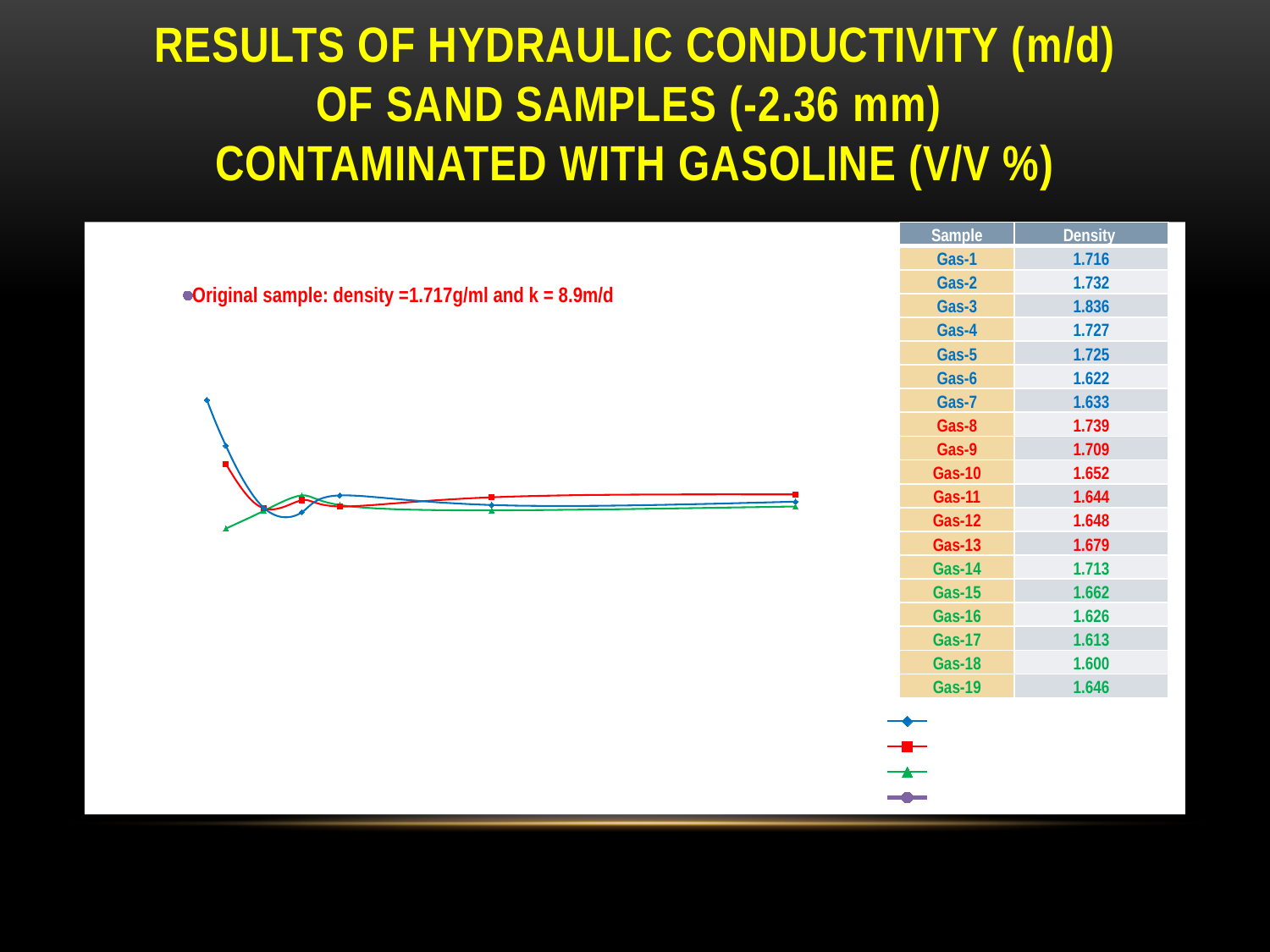
What colour is the line drawn with triangle markers? green Does the blue line rise or fall between its first and second points on the left? fall How many lines are actually plotted on the chart? 3 At the left edge of the chart, is the blue line's first point higher or lower than the red line's first point? higher Does the green line rise or fall between its first and second points on the left? rise What kind of chart is shown on the left of the slide? line chart Does the red line rise or fall between its first and second points on the left? fall Which line has the highest starting point at the left edge of the chart? the blue line How many series does the chart's legend list? 4 What colour is the line drawn with square markers? red Which line has the lowest starting point at the left edge of the chart? the green line